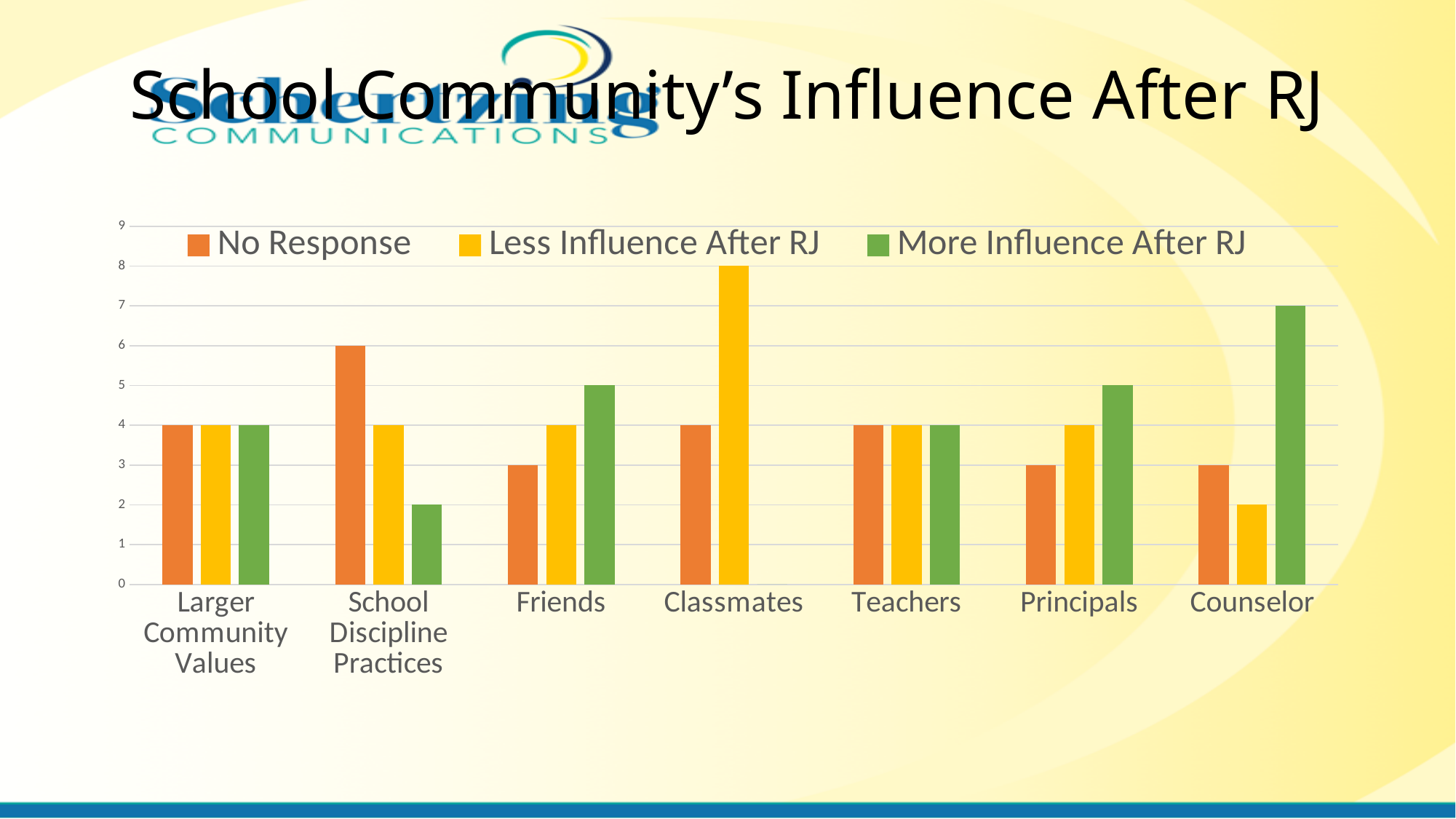
What is the difference between More Influence After RJ and Less Influence After RJ for Counselor? 5 What is the value of No Response for School Discipline Practices? 6 What is the title of the chart? School Community's Influence After RJ Which category has the highest Less Influence After RJ value? Classmates What is the value of More Influence After RJ for Counselor? 7 Which category has the lowest More Influence After RJ value? Classmates How many categories are shown on the x axis? 7 What type of chart is shown on the slide? bar chart How many series does the legend list? 3 What is the value of Less Influence After RJ for Classmates? 8 For School Discipline Practices, which is larger: No Response or More Influence After RJ? No Response Is the value of Less Influence After RJ for Classmates greater or less than 6? greater